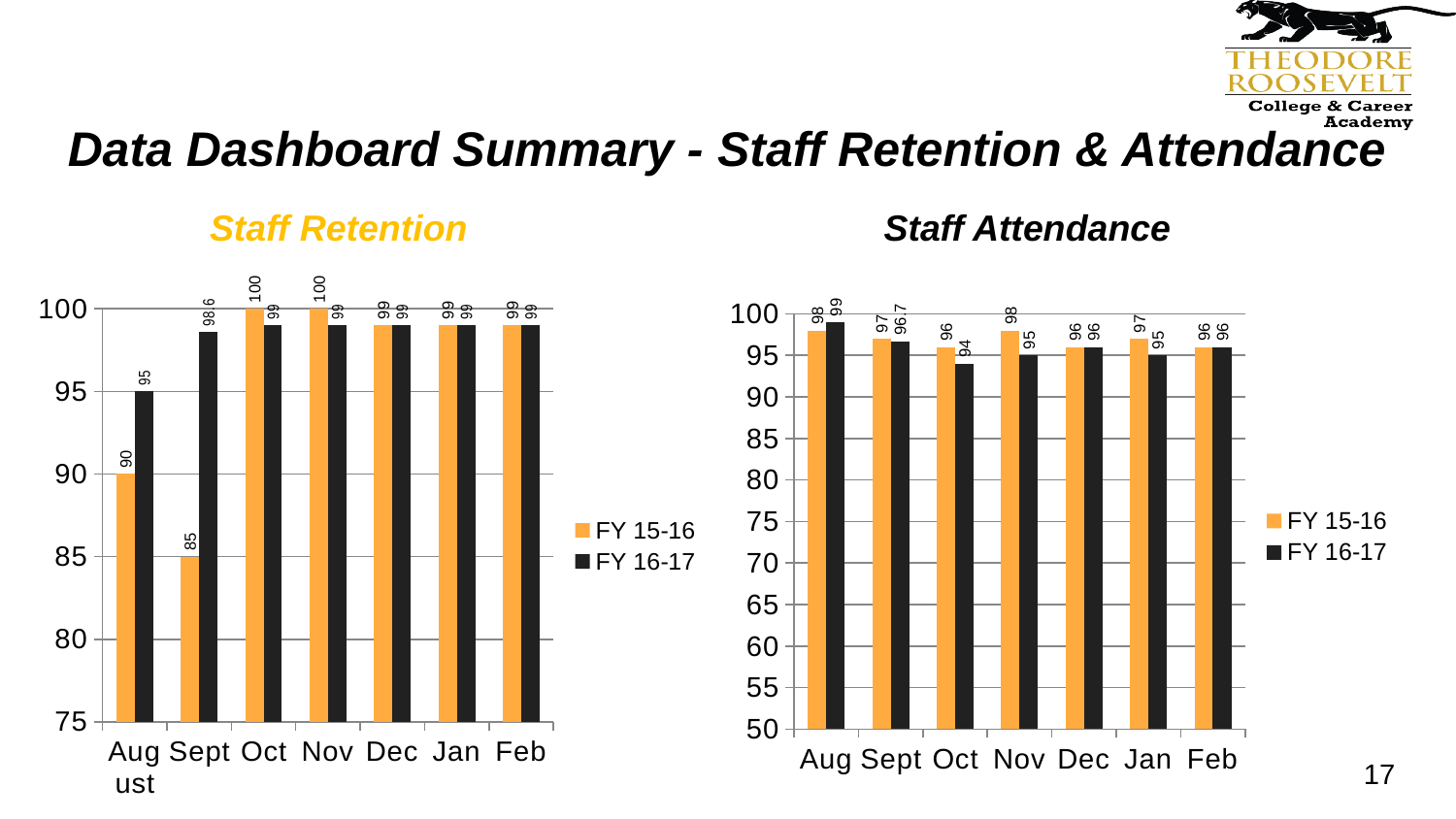
How many months are shown on the x axis of the Staff Attendance chart? 7 In the Staff Retention chart, what is the FY 16-17 value for Sept? 98.6 In the Staff Retention chart, what is the difference between the FY 16-17 and FY 15-16 values for August? 5 In the Staff Retention chart, which is larger for Oct: FY 15-16 or FY 16-17? FY 15-16 What type of chart is the Staff Attendance chart? Bar chart In the Staff Attendance chart, what is the FY 16-17 value for Sept? 96.7 In the Staff Retention chart, which month has the lowest FY 15-16 value? Sept In the Staff Retention chart, what is the FY 15-16 value for Sept? 85 In the Staff Attendance chart, which month has the lowest FY 16-17 value? Oct In the Staff Attendance chart, what is the difference between the FY 15-16 and FY 16-17 values for Nov? 3 How many series does the legend of the Staff Retention chart list? 2 In the Staff Attendance chart, what is the FY 16-17 value for Oct? 94